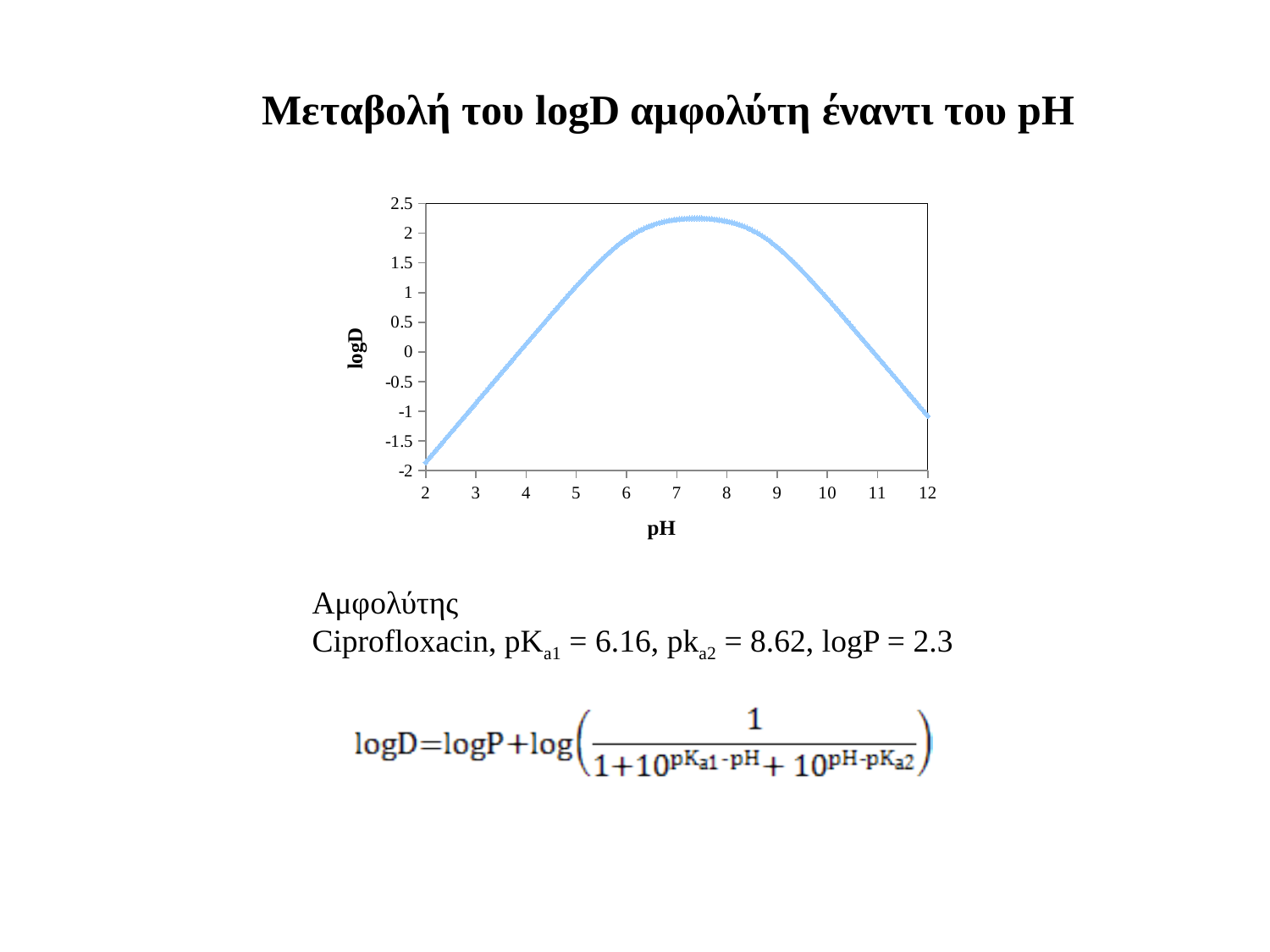
Is the logD value at pH 8 greater or less than 1.5? greater Is the logD value at pH 2 greater or less than -1.5? less Does logD rise or fall as pH increases from 9 to 12? fall Is the logD value at pH 12 greater or less than -0.5? less What is the label of the x axis of the chart? pH Does logD rise or fall as pH increases from 2 to 6? rise What is the label of the y axis of the chart? logD What kind of chart is shown on the slide? scatter chart Which is larger, the logD value at pH 2 or at pH 12? pH 12 Which is larger, the logD value at pH 7 or at pH 12? pH 7